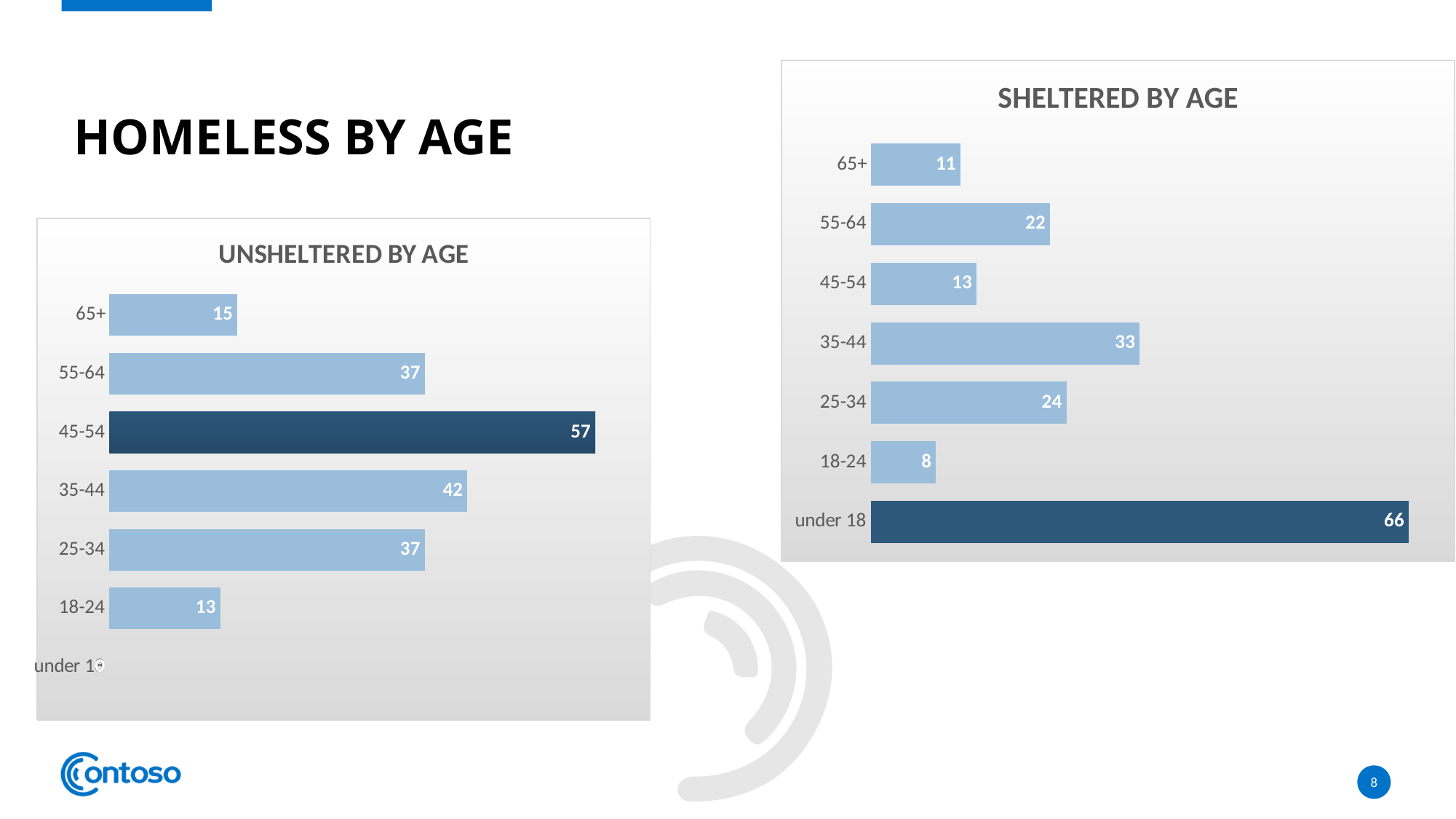
In the Sheltered by Age chart, which is larger, the value for 55-64 or the value for 45-54? 55-64 In the Unsheltered by Age chart, what is the value for the 45-54 age group? 57 In the Sheltered by Age chart, what is the difference between the values for under 18 and 25-34? 42 In the Unsheltered by Age chart, which age group has the highest value? 45-54 In the Sheltered by Age chart, what is the value for the under 18 age group? 66 In the Sheltered by Age chart, which age group has the highest value? under 18 In the Sheltered by Age chart, what is the value for the 35-44 age group? 33 In the Sheltered by Age chart, which age group has the lowest value? 18-24 What type of chart is the Sheltered by Age chart? bar chart In the Unsheltered by Age chart, what is the difference between the values for 45-54 and 35-44? 15 How many age groups are shown in the Sheltered by Age chart? 7 In the Unsheltered by Age chart, which is larger, the value for 55-64 or the value for 65+? 55-64